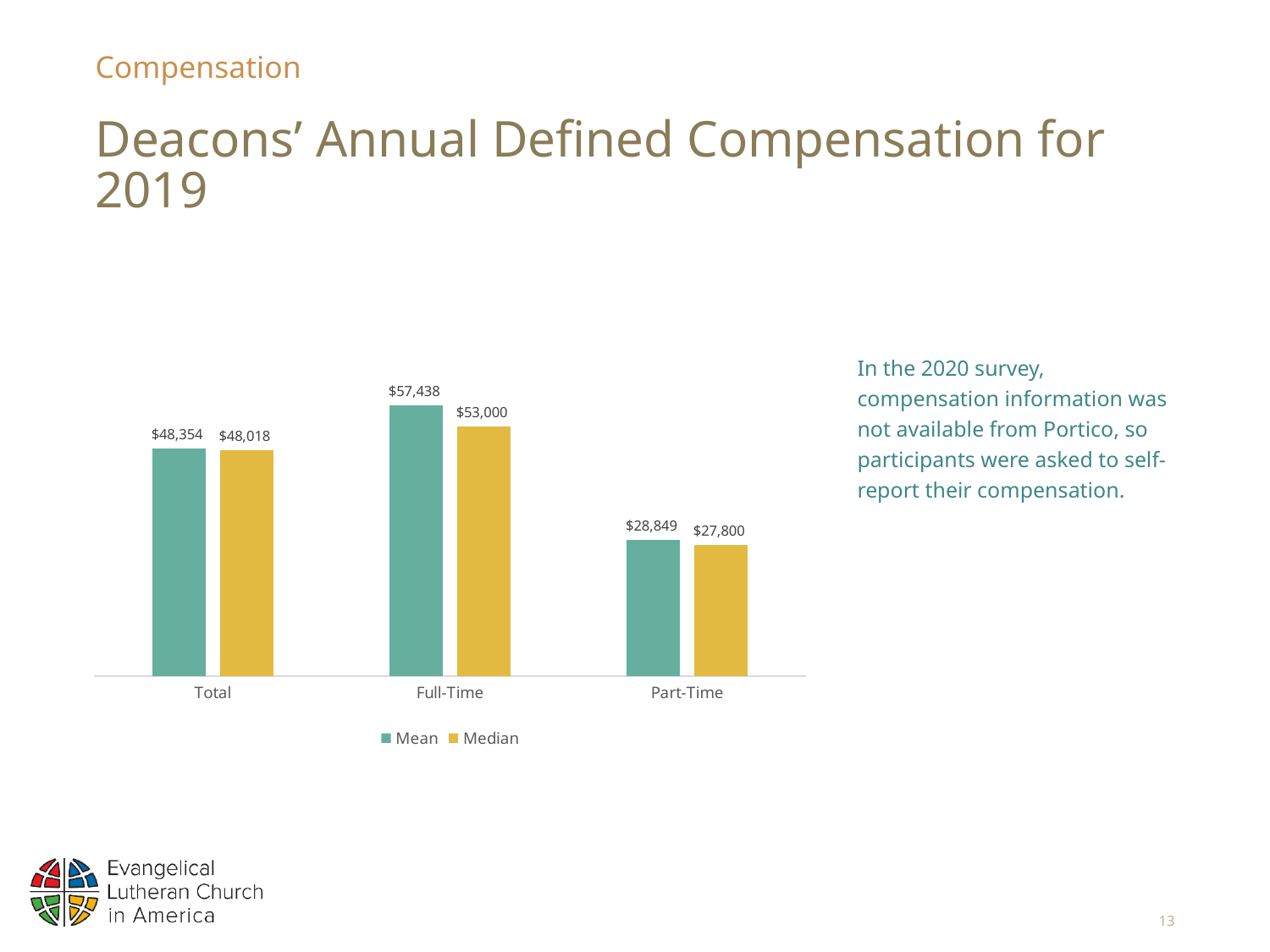
What is the difference between the mean and median compensation for Full-Time deacons? $4,438 What is the difference between the mean compensation for Full-Time and Part-Time deacons? $28,589 What is the mean annual defined compensation for Part-Time deacons? $28,849 Which category has the lowest median compensation? Part-Time How many series does the chart legend list? 2 Which category has the highest mean compensation? Full-Time Which is larger, the mean compensation for Total or the median compensation for Full-Time? Median compensation for Full-Time How many categories are shown on the x axis of the chart? 3 What kind of chart is shown on the slide? Bar chart What is the median annual defined compensation for Part-Time deacons? $27,800 What is the mean annual defined compensation for Full-Time deacons? $57,438 What is the median annual defined compensation for the Total category? $48,018